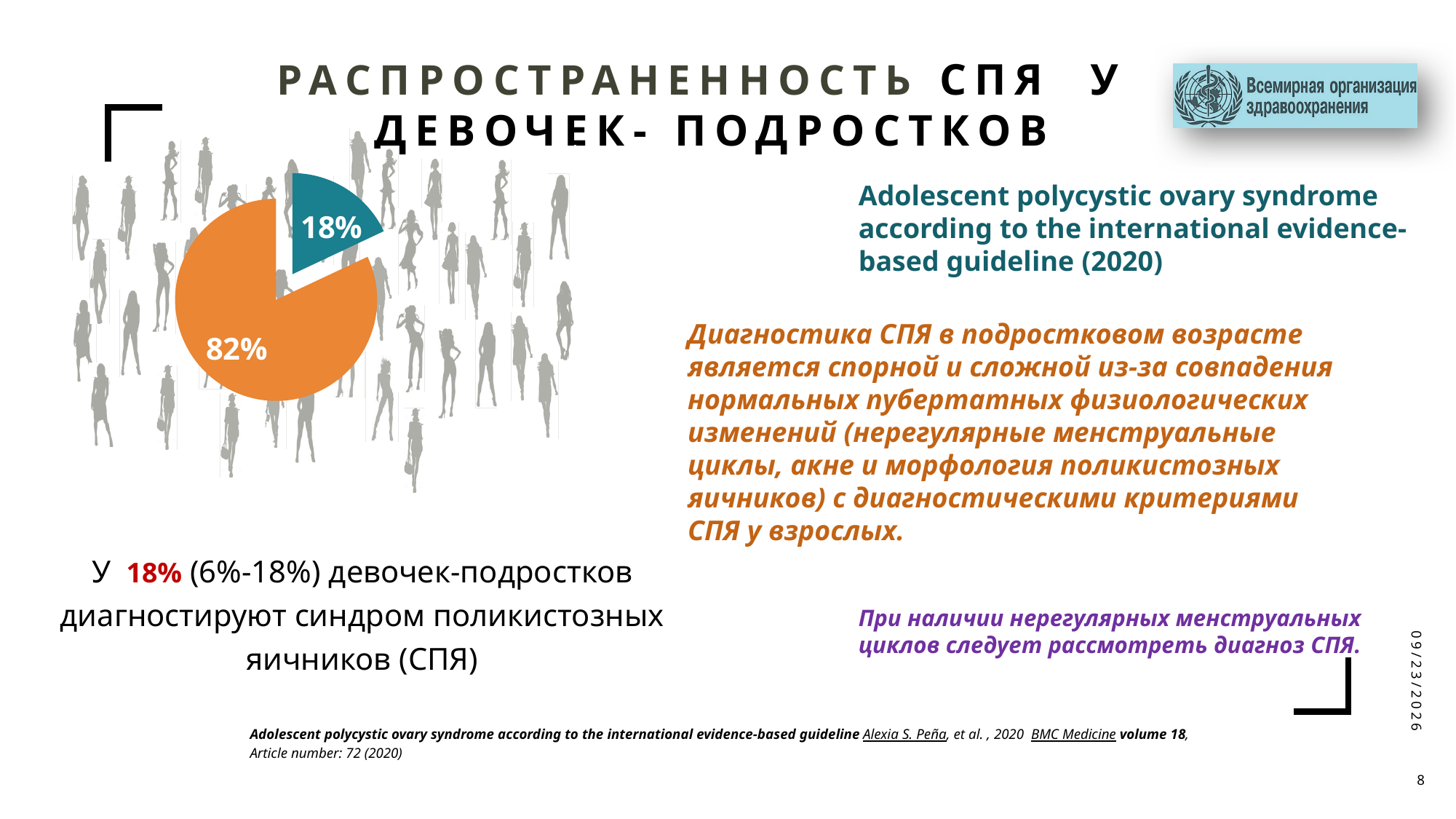
Which is larger in the pie chart, the orange slice or the teal slice? the orange slice What share of the pie does the teal slice represent? 18% What kind of chart is shown on the left of the slide? pie chart What value is labelled on the orange slice of the pie chart? 82% What do the two slice values of the pie chart add up to? 100% What is the difference between the two slice values in the pie chart? 64 percentage points What value is labelled on the teal slice of the pie chart? 18% Which slice of the pie chart is the largest? the orange slice (82%) Which slice of the pie chart is pulled out (exploded) from the rest? the teal 18% slice How many slices does the pie chart have? 2 What colour is the 82% slice of the pie chart? orange Which slice of the pie chart is the smallest? the teal slice (18%)